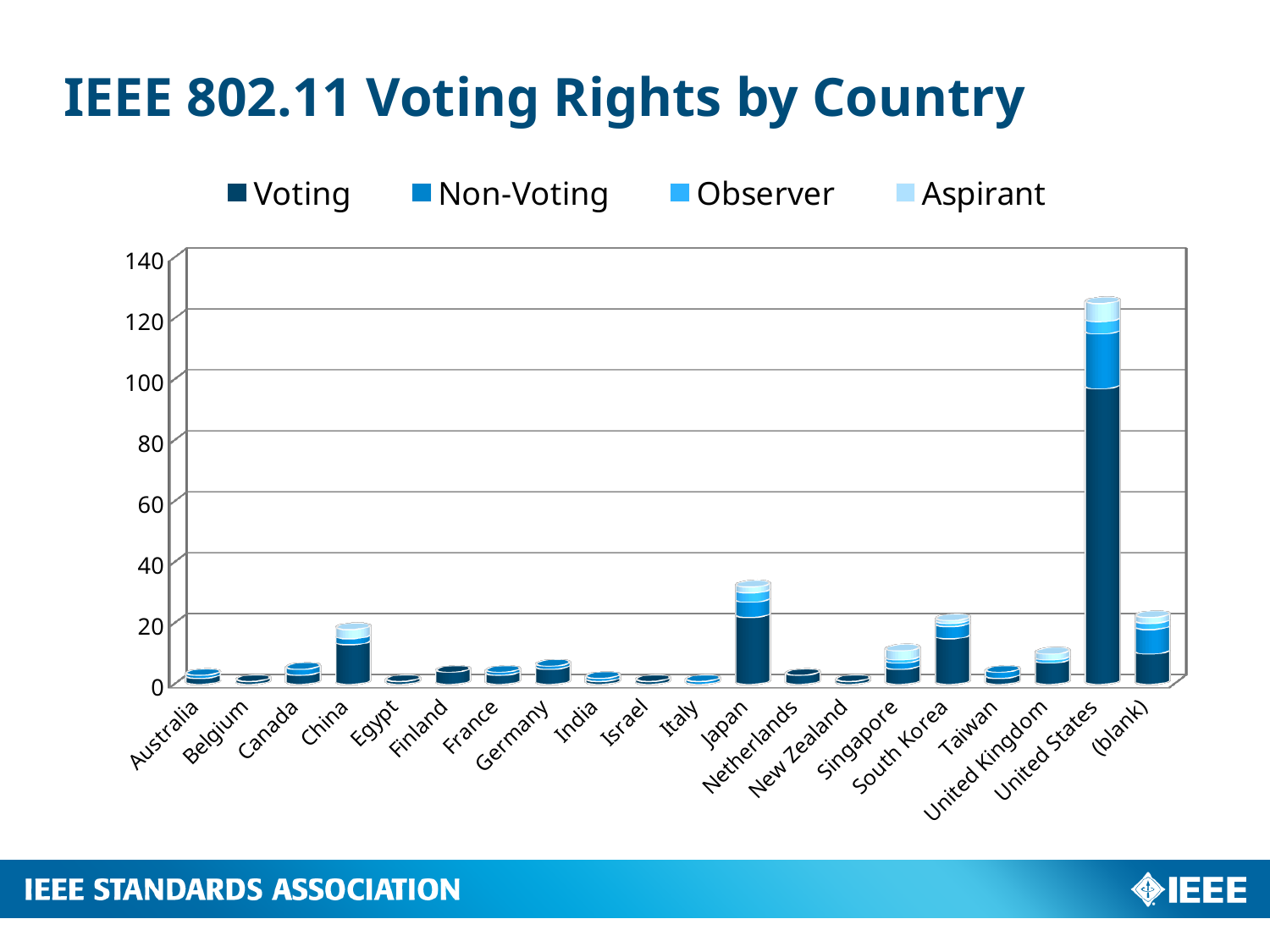
Is the total stacked value for Australia greater or less than 20? less What is the title of the chart? IEEE 802.11 Voting Rights by Country What kind of chart is shown on the slide? Stacked bar chart How many countries (categories) are shown on the x axis? 20 Is the total stacked value for China greater or less than 40? less Is the total stacked value for United States greater or less than 100? greater Which series are listed in the legend? Voting, Non-Voting, Observer, Aspirant Which has the larger total stacked bar, Japan or South Korea? Japan Which country has the tallest stacked bar? United States Which has the larger total stacked bar, United States or Japan? United States How many series does the legend list? 4